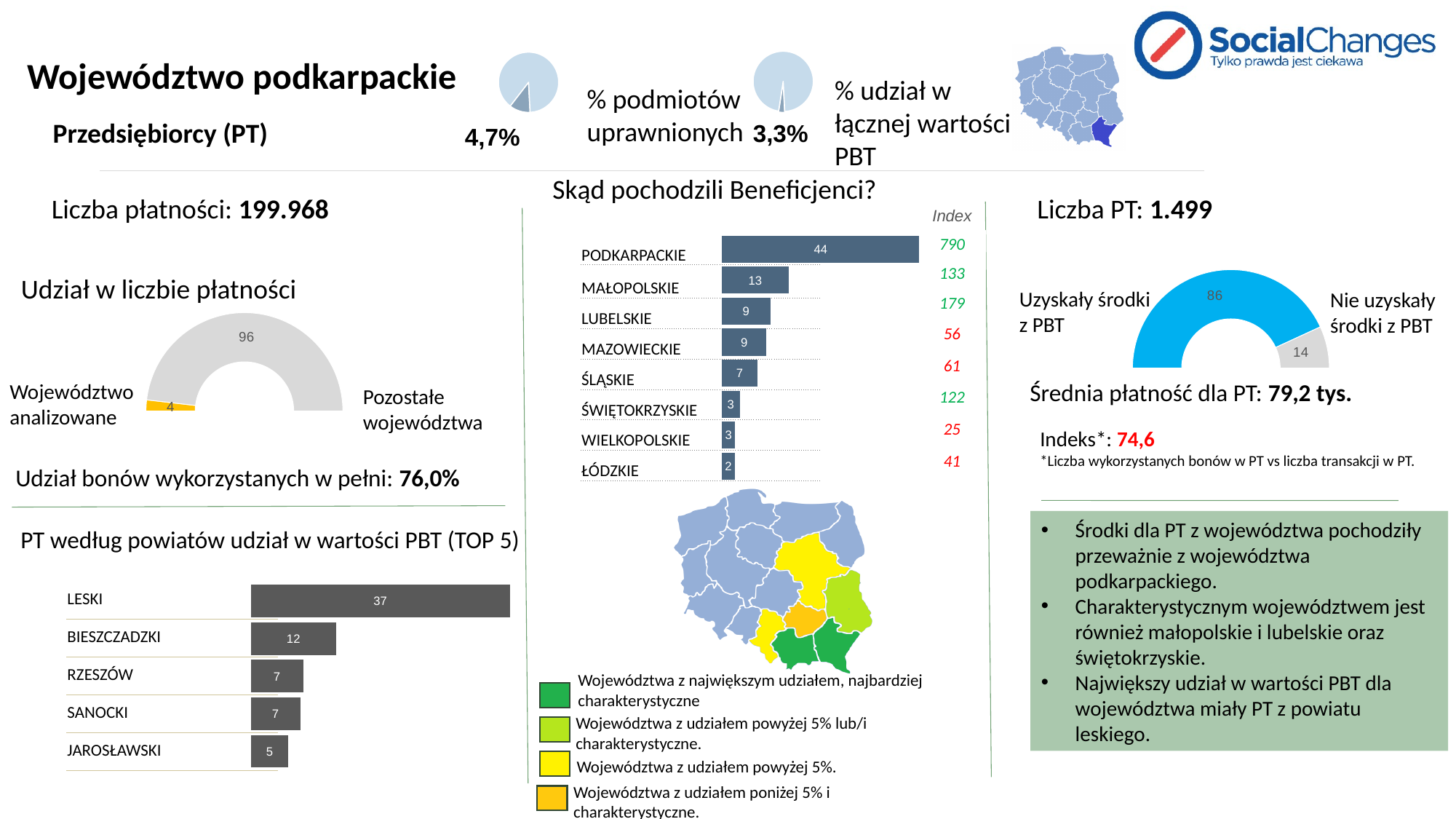
In the 'Skąd pochodzili Beneficjenci?' chart, what is the value for PODKARPACKIE? 44 How many regions are listed in the 'Skąd pochodzili Beneficjenci?' bar chart? 8 In the 'Skąd pochodzili Beneficjenci?' chart, what is the difference between PODKARPACKIE and MAŁOPOLSKIE? 31 In the 'PT według powiatów udział w wartości PBT (TOP 5)' chart, which powiat has the highest value? LESKI In the 'PT według powiatów udział w wartości PBT (TOP 5)' chart, what is the difference between LESKI and BIESZCZADZKI? 25 In the 'Skąd pochodzili Beneficjenci?' chart, what is the value for MAŁOPOLSKIE? 13 In the 'PT według powiatów udział w wartości PBT (TOP 5)' chart, which is larger: BIESZCZADZKI or JAROSŁAWSKI? BIESZCZADZKI In the 'Skąd pochodzili Beneficjenci?' chart, which region has the lowest value? ŁÓDZKIE In the 'Udział w liczbie płatności' chart, what is the value for 'Pozostałe województwa'? 96 In the 'Liczba PT' donut chart, what is the value for 'Nie uzyskały środki z PBT'? 14 In the 'PT według powiatów udział w wartości PBT (TOP 5)' chart, what is the value for LESKI? 37 What type of chart is 'PT według powiatów udział w wartości PBT (TOP 5)'? Bar chart